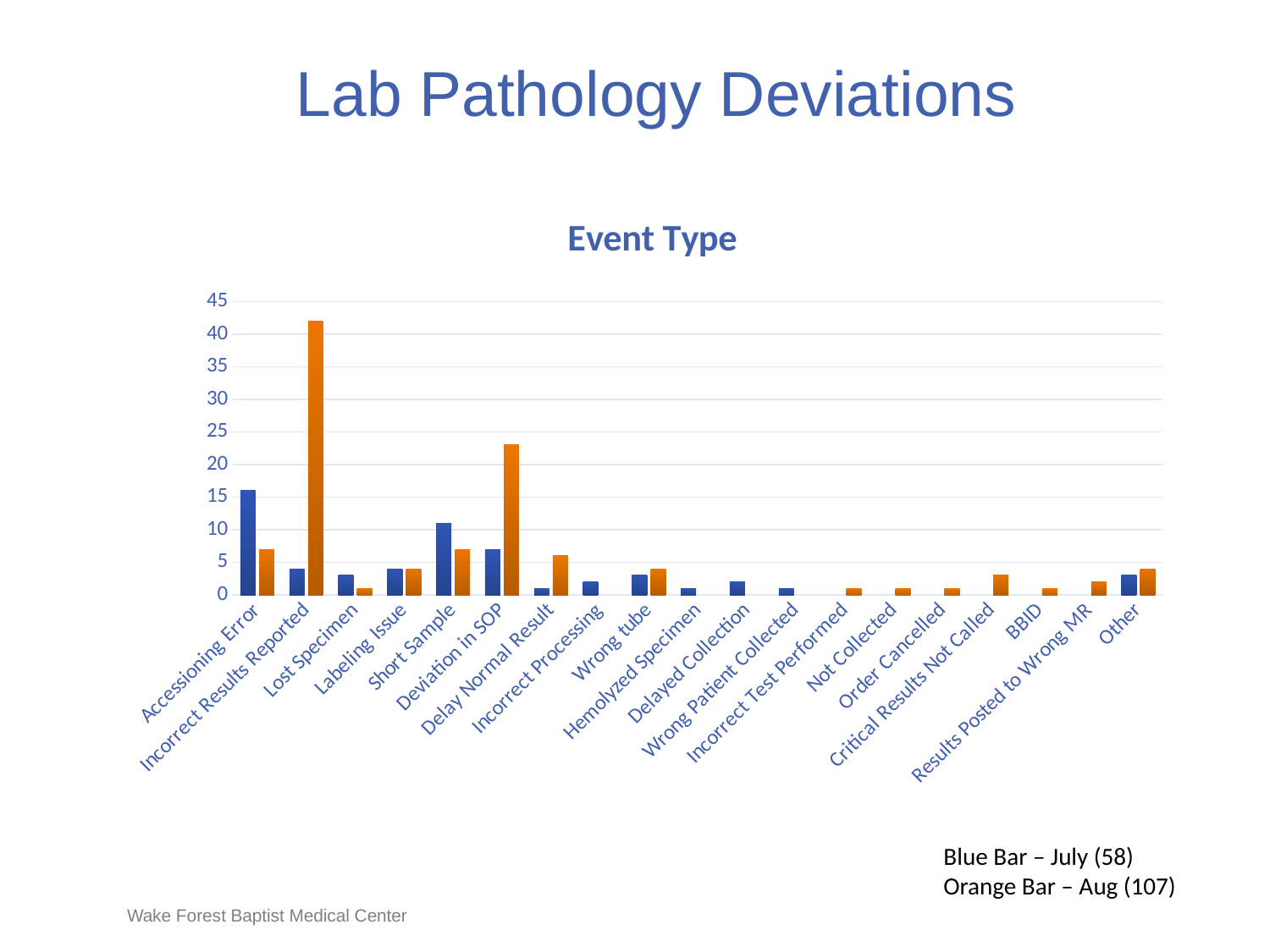
Which event type has the tallest blue (July) bar? Accessioning Error According to the slide, which month do the blue bars represent? July Is the orange (Aug) value for Incorrect Results Reported greater or less than 35? greater For Deviation in SOP, which bar is taller, the blue (July) bar or the orange (Aug) bar? orange (Aug) What kind of chart is shown on the slide? bar chart For Accessioning Error, which bar is taller, the blue (July) bar or the orange (Aug) bar? blue (July) Is the blue (July) value for Accessioning Error greater or less than 10? greater Is the orange (Aug) value for Deviation in SOP greater or less than 20? greater Which event type has the tallest orange (Aug) bar? Incorrect Results Reported How many event type categories are shown on the x axis of the chart? 19 What is the title of the chart? Event Type